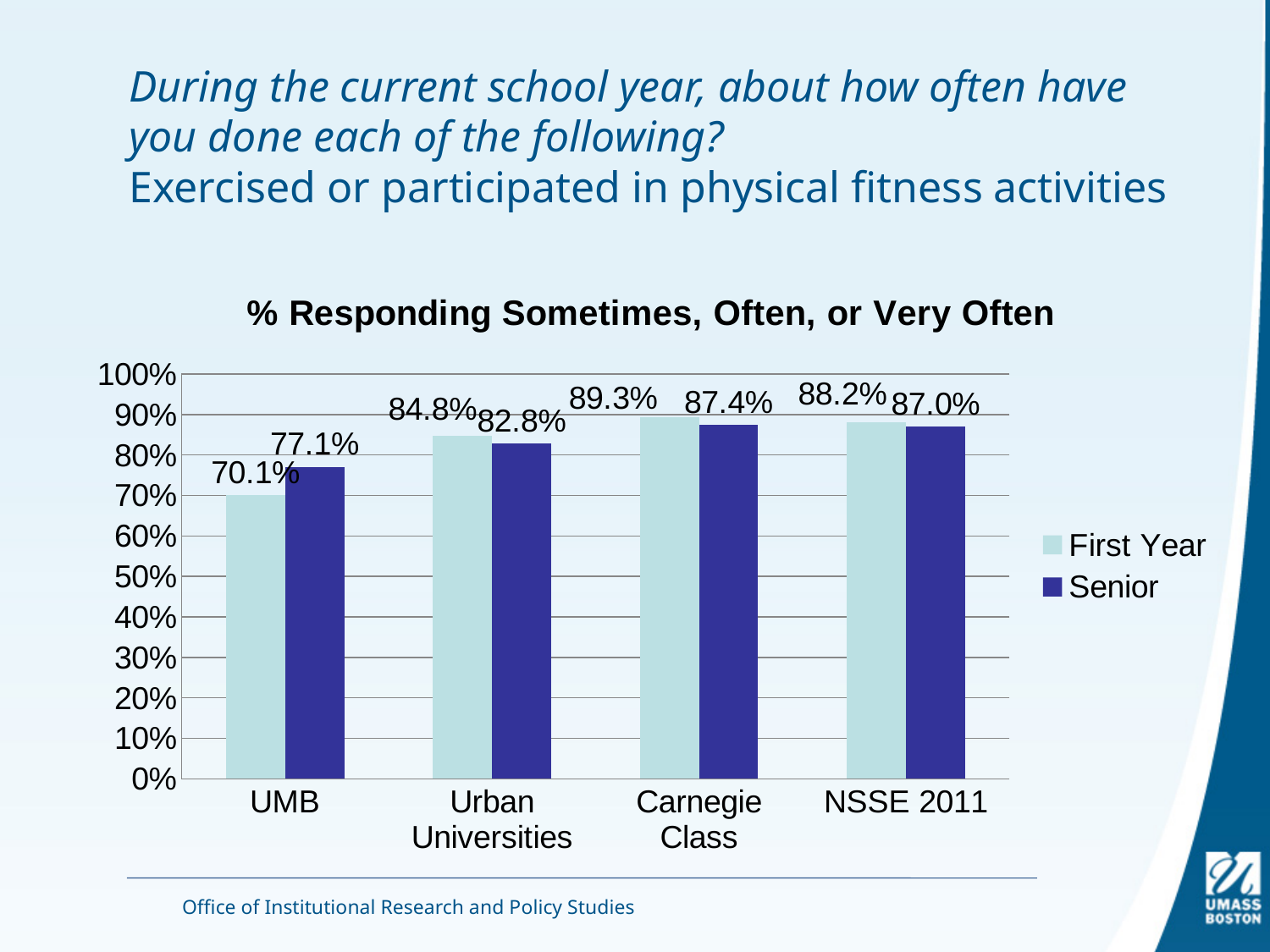
What kind of chart is shown on the slide? Bar chart Which category has the lowest Senior value? UMB What is the Senior value for NSSE 2011? 87.0% For Urban Universities, which is larger: the First Year value or the Senior value? First Year How many series does the legend list? 2 What is the difference between the Senior and First Year values for UMB? 7.0% Which category has the highest First Year value? Carnegie Class What is the First Year value for Carnegie Class? 89.3% What is the title of the chart? % Responding Sometimes, Often, or Very Often What is the Senior value for Urban Universities? 82.8% How many categories are shown on the x axis? 4 What is the First Year value for UMB? 70.1%